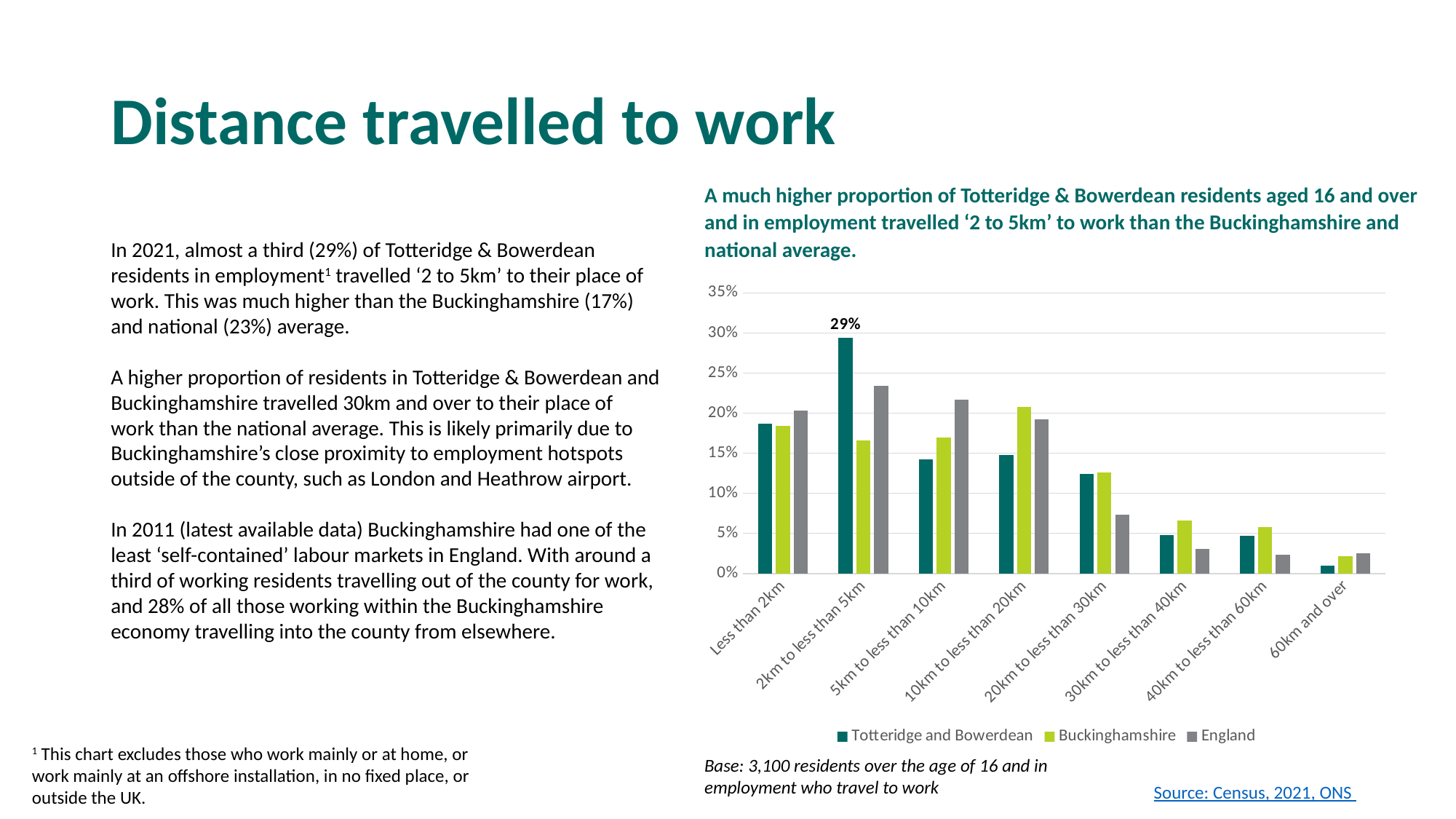
Which distance category has the lowest value for Totteridge and Bowerdean? 60km and over Which colour represents England in the chart's legend? Grey Do the Buckinghamshire values rise or fall from '10km to less than 20km' through to '60km and over'? fall What kind of chart is shown on the slide? Bar chart Which distance category has the highest value for Totteridge and Bowerdean? 2km to less than 5km How many series does the chart's legend list? 3 In the '2km to less than 5km' category, which is larger: Totteridge and Bowerdean or Buckinghamshire? Totteridge and Bowerdean Is the England value for '2km to less than 5km' greater or less than 20%? greater How many distance categories are shown on the x axis of the chart? 8 In the '10km to less than 20km' category, which is larger: Buckinghamshire or Totteridge and Bowerdean? Buckinghamshire What percentage of Totteridge and Bowerdean residents travelled '2km to less than 5km' to work? 29% Is the Buckinghamshire value for '2km to less than 5km' greater or less than 20%? less